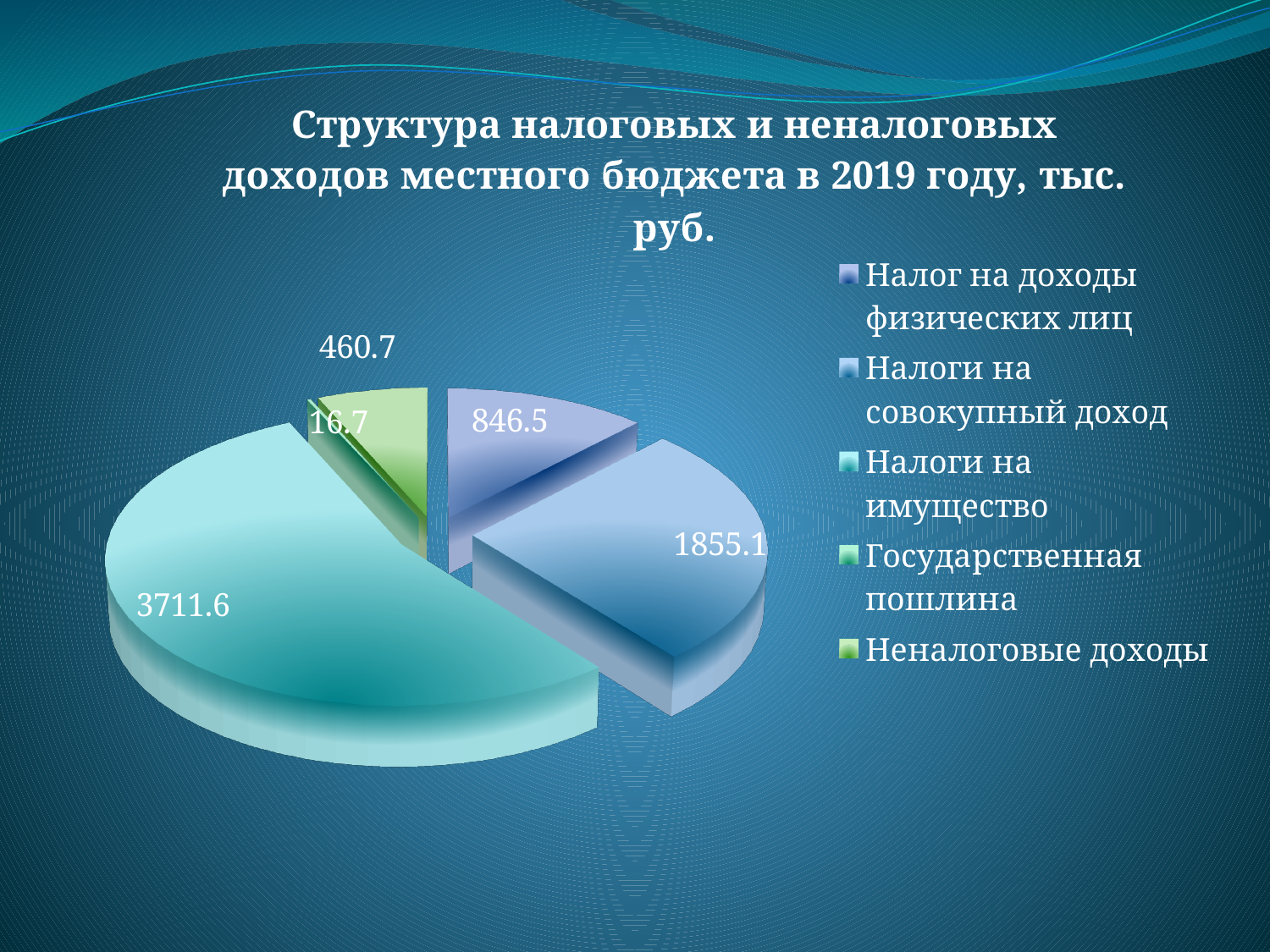
What is the value for Налог на доходы физических лиц? 846.5 What is the difference between Налоги на имущество and Налоги на совокупный доход? 1856.5 What is the value for Государственная пошлина? 16.7 Which is larger, Налоги на совокупный доход or Налог на доходы физических лиц? Налоги на совокупный доход Which category has the smallest slice of the pie? Государственная пошлина What is the title of the chart? Структура налоговых и неналоговых доходов местного бюджета в 2019 году, тыс. руб. What is the value for Неналоговые доходы? 460.7 What is the difference between Неналоговые доходы and Государственная пошлина? 444.0 How many categories does the pie chart show? 5 Which category has the largest slice of the pie? Налоги на имущество What type of chart is shown on the slide? Pie chart What is the value for Налоги на имущество? 3711.6